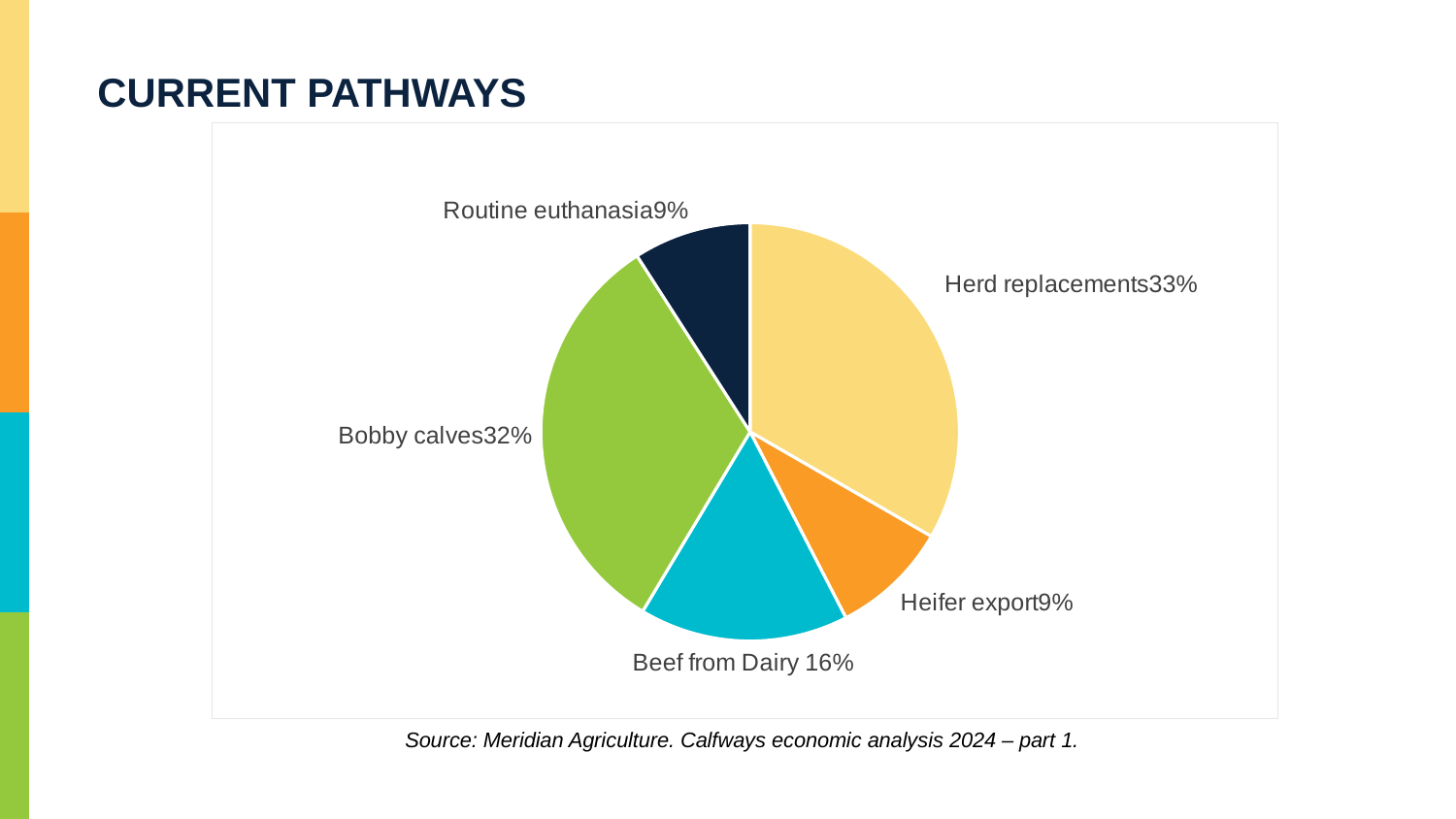
What share of the pie is Bobby calves? 32% Which category has the largest share of the pie? Herd replacements Which is larger, the share for Bobby calves or the share for Beef from Dairy? Bobby calves What is the difference in percentage points between Bobby calves and Beef from Dairy? 16 What kind of chart is shown on the slide? pie chart What is the difference in percentage points between Herd replacements and Heifer export? 24 What share of the pie is Heifer export? 9% What is the title of the slide containing the chart? CURRENT PATHWAYS What share of the pie is Herd replacements? 33% What share of the pie is Beef from Dairy? 16% What share of the pie is Routine euthanasia? 9% How many slices does the pie chart have? 5